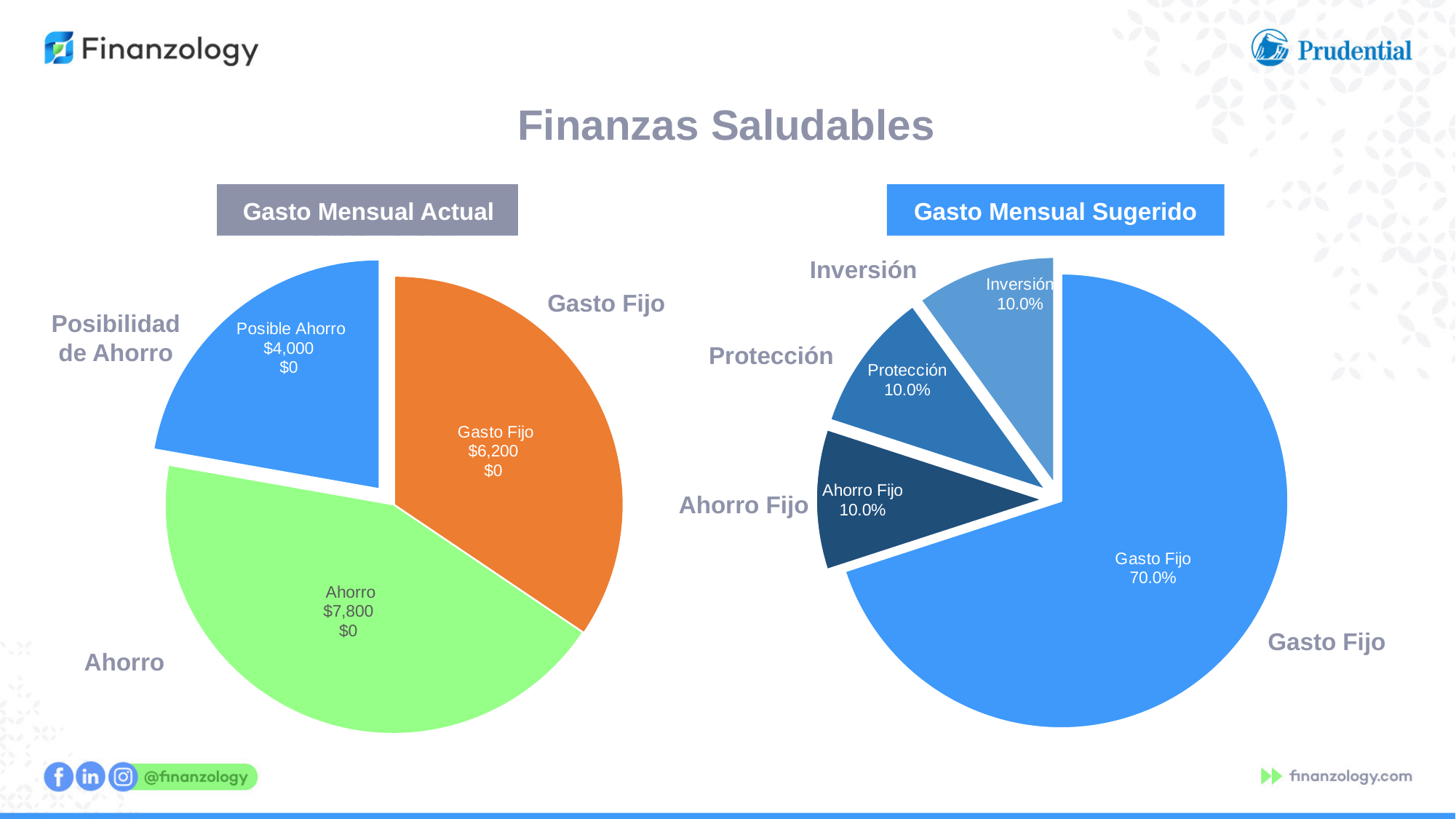
In the 'Gasto Mensual Actual' chart, which slice is the smallest? Posible Ahorro In the 'Gasto Mensual Actual' chart, what is the difference between Ahorro and Gasto Fijo? $1,600 How many slices does the 'Gasto Mensual Sugerido' chart have? 4 In the 'Gasto Mensual Sugerido' chart, what percentage is Protección? 10.0% What kind of chart is the 'Gasto Mensual Actual' chart? Pie chart In the 'Gasto Mensual Actual' chart, what is the value for Posible Ahorro? $4,000 In the 'Gasto Mensual Sugerido' chart, what percentage is Gasto Fijo? 70.0% In the 'Gasto Mensual Actual' chart, which is larger, Gasto Fijo or Posible Ahorro? Gasto Fijo In the 'Gasto Mensual Actual' chart, what is the value for Gasto Fijo? $6,200 In the 'Gasto Mensual Sugerido' chart, what is the combined percentage of Inversión, Protección and Ahorro Fijo? 30.0% In the 'Gasto Mensual Actual' chart, which slice is the largest? Ahorro In the 'Gasto Mensual Actual' chart, what is the value for Ahorro? $7,800